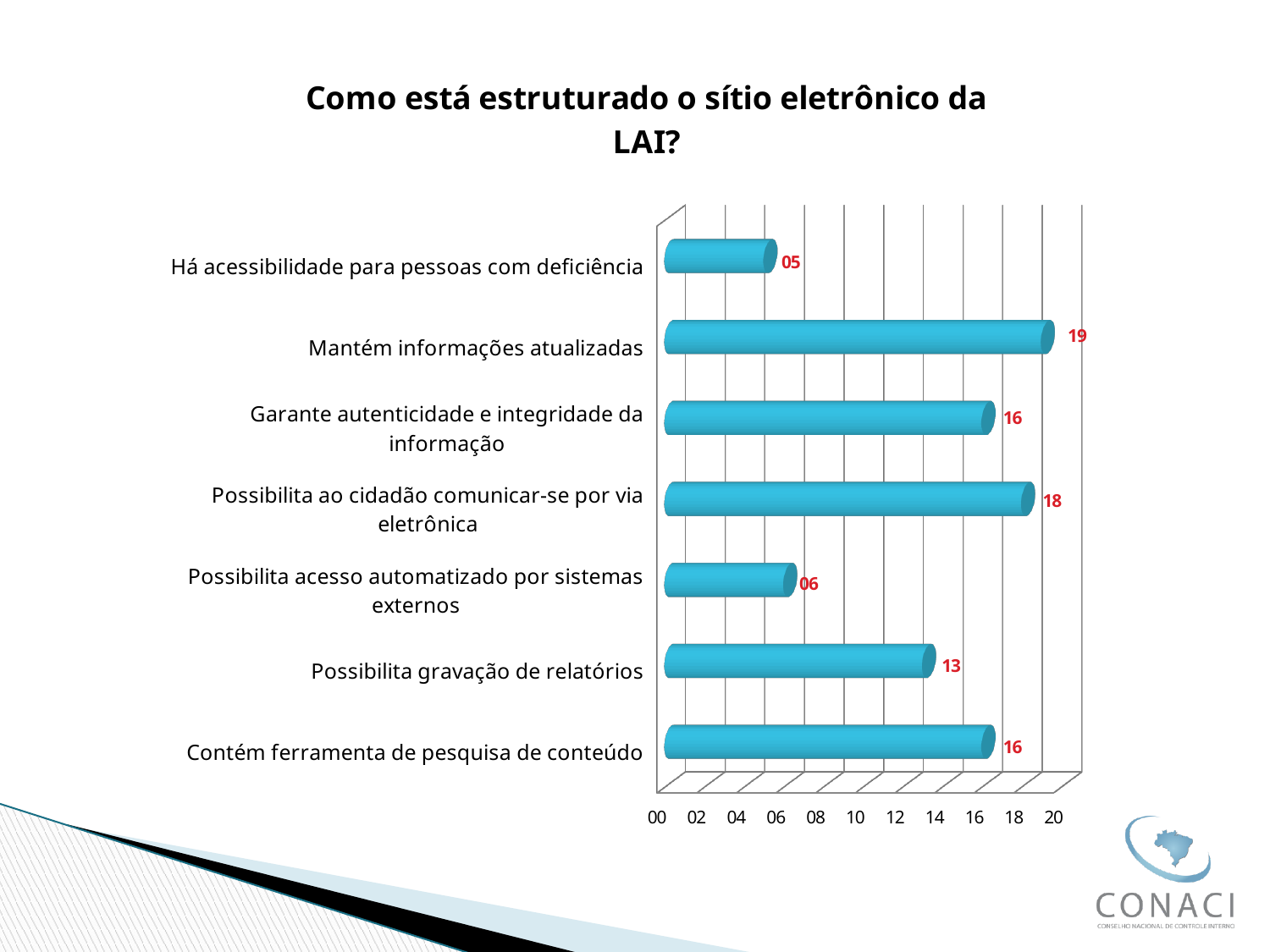
Is the value for "Contém ferramenta de pesquisa de conteúdo" greater or less than 10? greater Which category has the highest value? Mantém informações atualizadas What value is shown for "Possibilita gravação de relatórios"? 13 Which category has the lowest value? Há acessibilidade para pessoas com deficiência What value is shown for "Mantém informações atualizadas"? 19 What kind of chart is shown on the slide? bar chart How many categories are shown in the chart? 7 What value is shown for "Possibilita acesso automatizado por sistemas externos"? 06 What value is shown for "Há acessibilidade para pessoas com deficiência"? 05 What is the difference between the values for "Mantém informações atualizadas" and "Possibilita gravação de relatórios"? 6 Which is larger: the value for "Possibilita ao cidadão comunicar-se por via eletrônica" or the value for "Garante autenticidade e integridade da informação"? Possibilita ao cidadão comunicar-se por via eletrônica What is the title of the chart? Como está estruturado o sítio eletrônico da LAI?